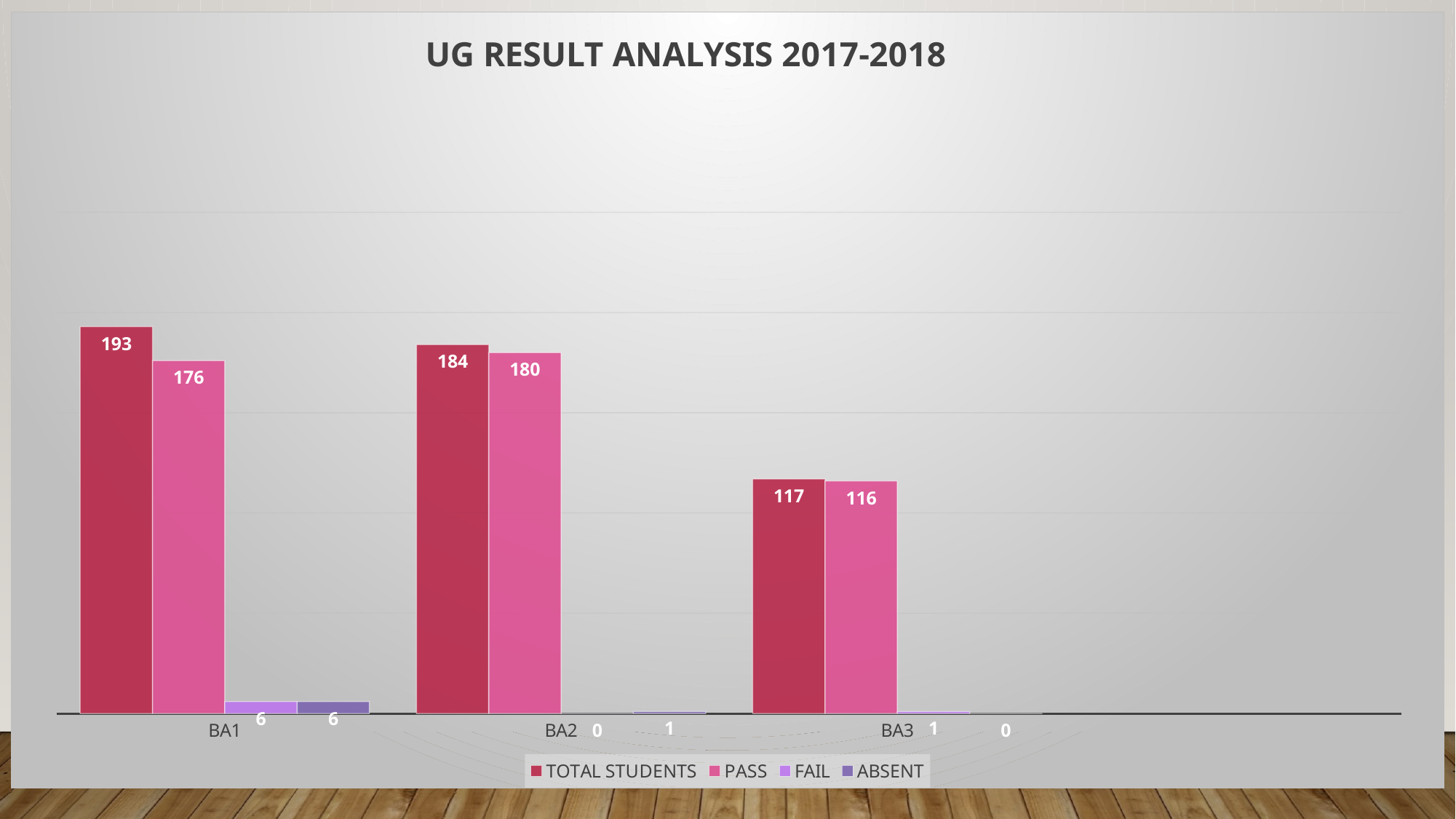
What is the title of the chart? UG RESULT ANALYSIS 2017-2018 What is the ABSENT value for BA3? 0 What is the difference between TOTAL STUDENTS and PASS for BA1? 17 How many categories are shown on the x axis? 3 What kind of chart is shown on the slide? Bar chart What is the FAIL value for BA1? 6 Which is larger, the PASS value for BA2 or the PASS value for BA1? BA2 What is the PASS value for BA2? 180 Which category has the highest TOTAL STUDENTS value? BA1 What is the value for TOTAL STUDENTS in BA1? 193 How many series does the legend list? 4 Which category has the lowest PASS value? BA3